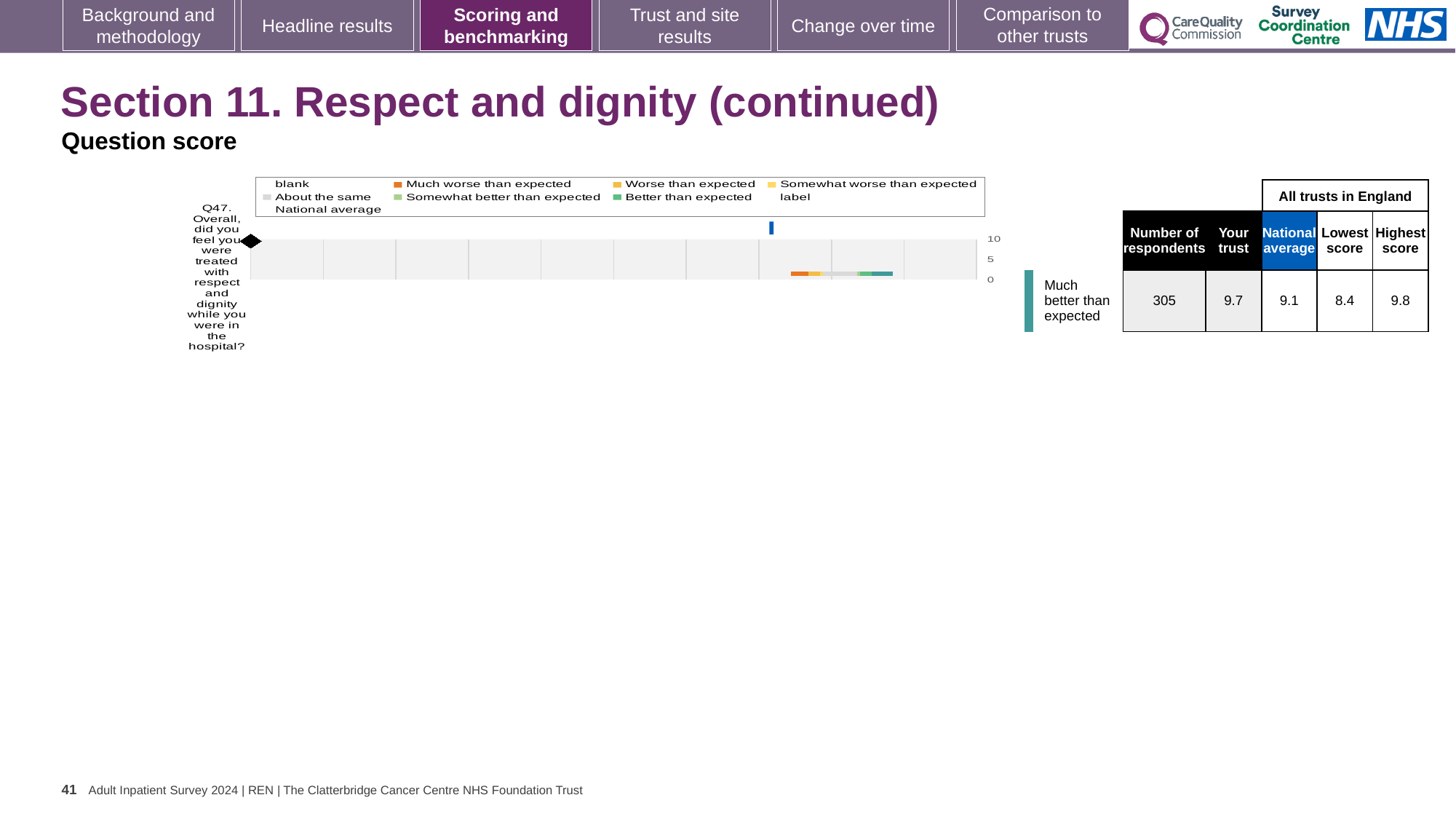
Is the Your trust score for Q47 greater or less than 5? greater What is the Lowest score among all trusts in England for Q47? 8.4 What is the score for Your trust on Q47? 9.7 How many respondents answered Q47? 305 What is the highest tick value shown on the chart's axis? 10 What is the National average score for Q47? 9.1 Which is larger for Q47, the Your trust score or the National average? Your trust What is the difference between the Your trust score and the National average for Q47? 0.6 Which survey question is plotted in the chart? Q47 What kind of chart is shown on the slide? bar chart What is the Highest score among all trusts in England for Q47? 9.8 What is the difference between the Highest score and the Lowest score for Q47? 1.4